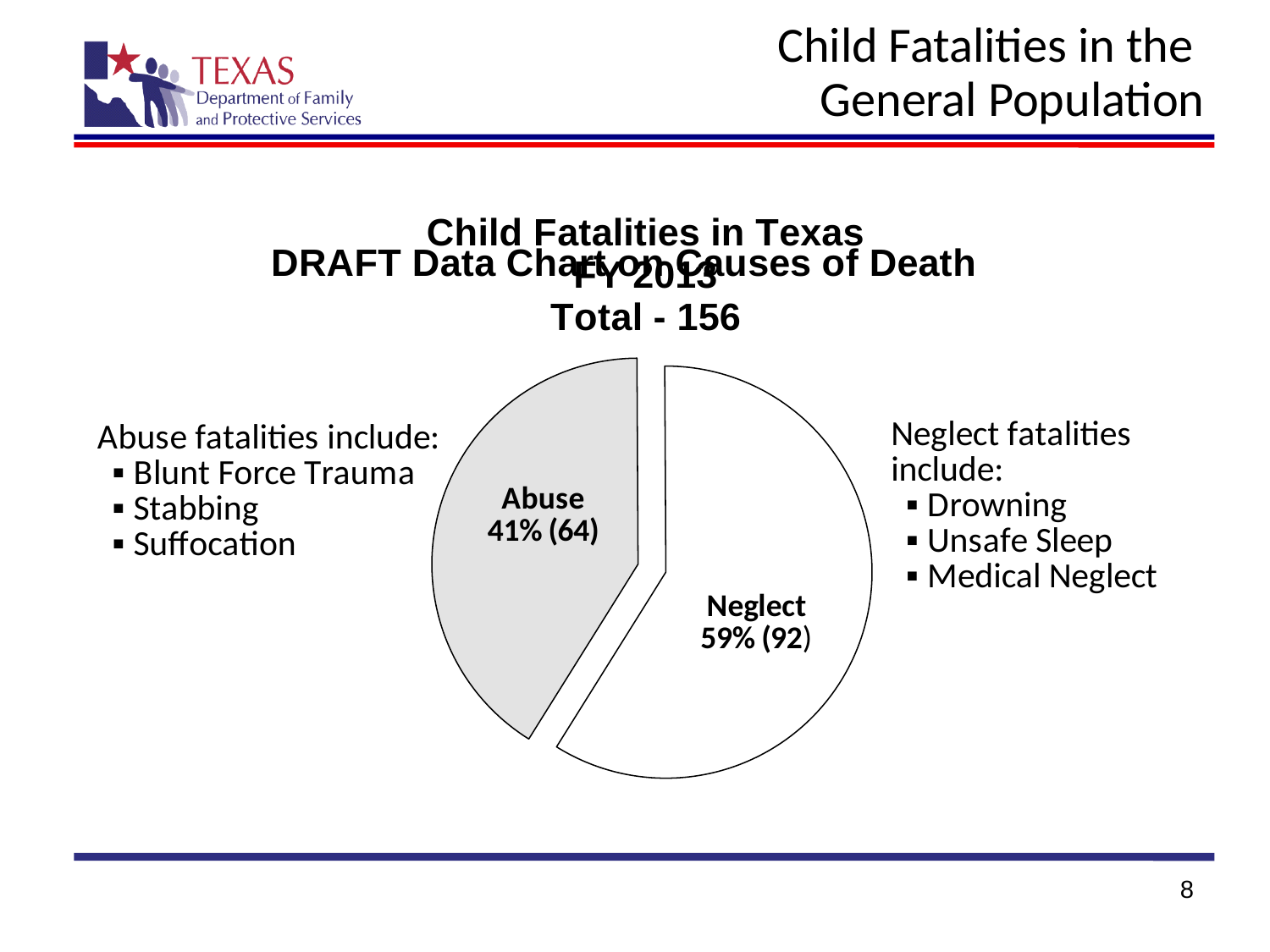
How many more fatalities are attributed to Neglect than to Abuse? 28 What kind of chart is shown on the slide? pie chart How many child fatalities are attributed to Abuse? 64 What is the total number of child fatalities shown in the chart? 156 How many child fatalities are attributed to Neglect? 92 What percentage of child fatalities is attributed to Abuse? 41% Which is larger, the number of Abuse fatalities or the number of Neglect fatalities? Neglect What percentage of child fatalities is attributed to Neglect? 59% Which slice of the pie is shaded grey? Abuse Which cause of death accounts for the smallest share of the pie? Abuse Which cause of death accounts for the largest share of the pie? Neglect How many slices does the pie chart have? 2